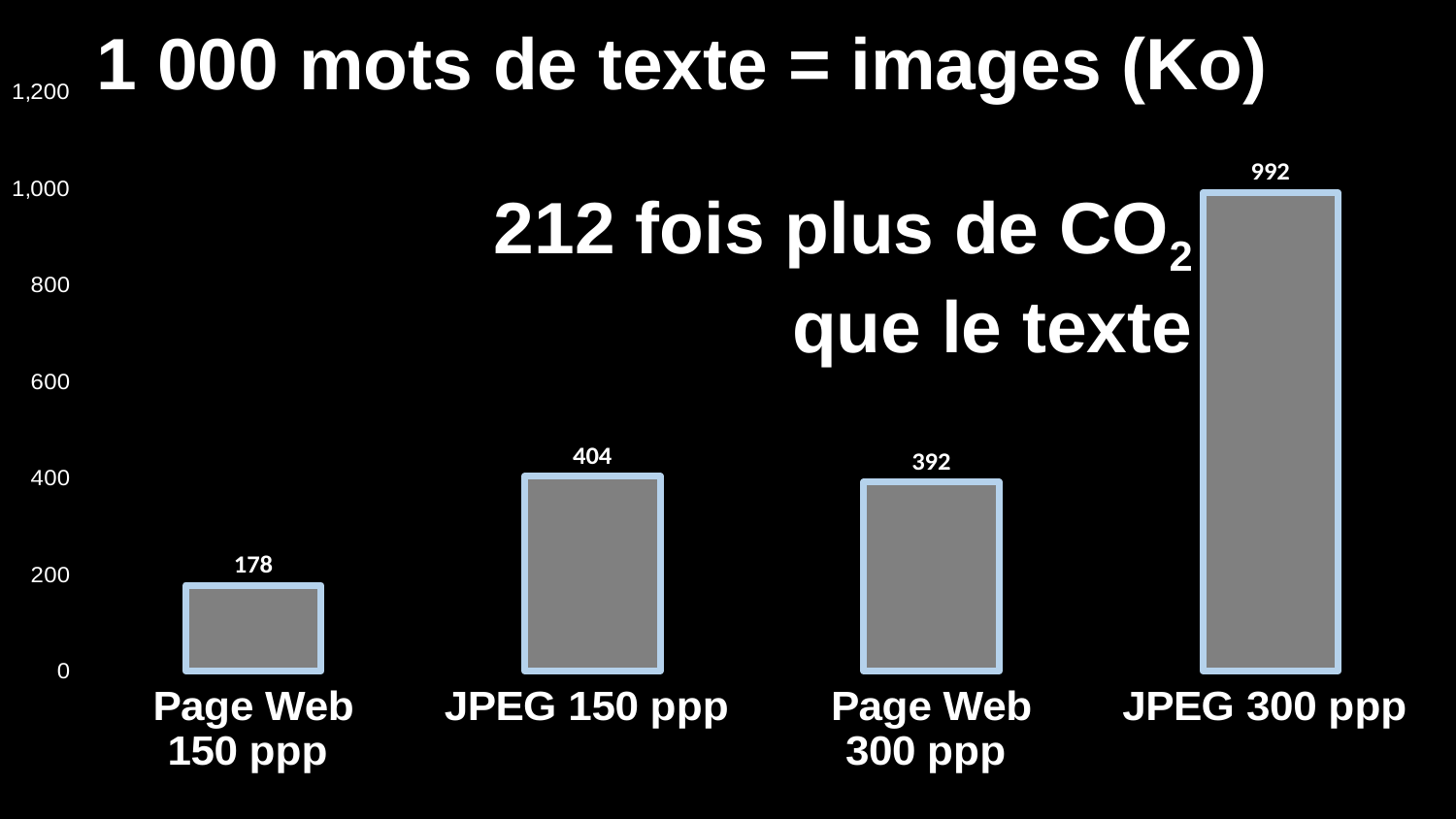
What kind of chart is shown on the slide? bar chart What is the value for Page Web 300 ppp? 392 What is the difference between the values for Page Web 300 ppp and Page Web 150 ppp? 214 Is the value for JPEG 300 ppp greater or less than 800? greater Which is larger, the value for JPEG 150 ppp or the value for Page Web 300 ppp? JPEG 150 ppp What is the difference between the values for JPEG 300 ppp and JPEG 150 ppp? 588 How many categories are shown in the chart? 4 Which category has the highest value? JPEG 300 ppp Which category has the lowest value? Page Web 150 ppp What is the value for Page Web 150 ppp? 178 What is the value for JPEG 150 ppp? 404 What is the value for JPEG 300 ppp? 992